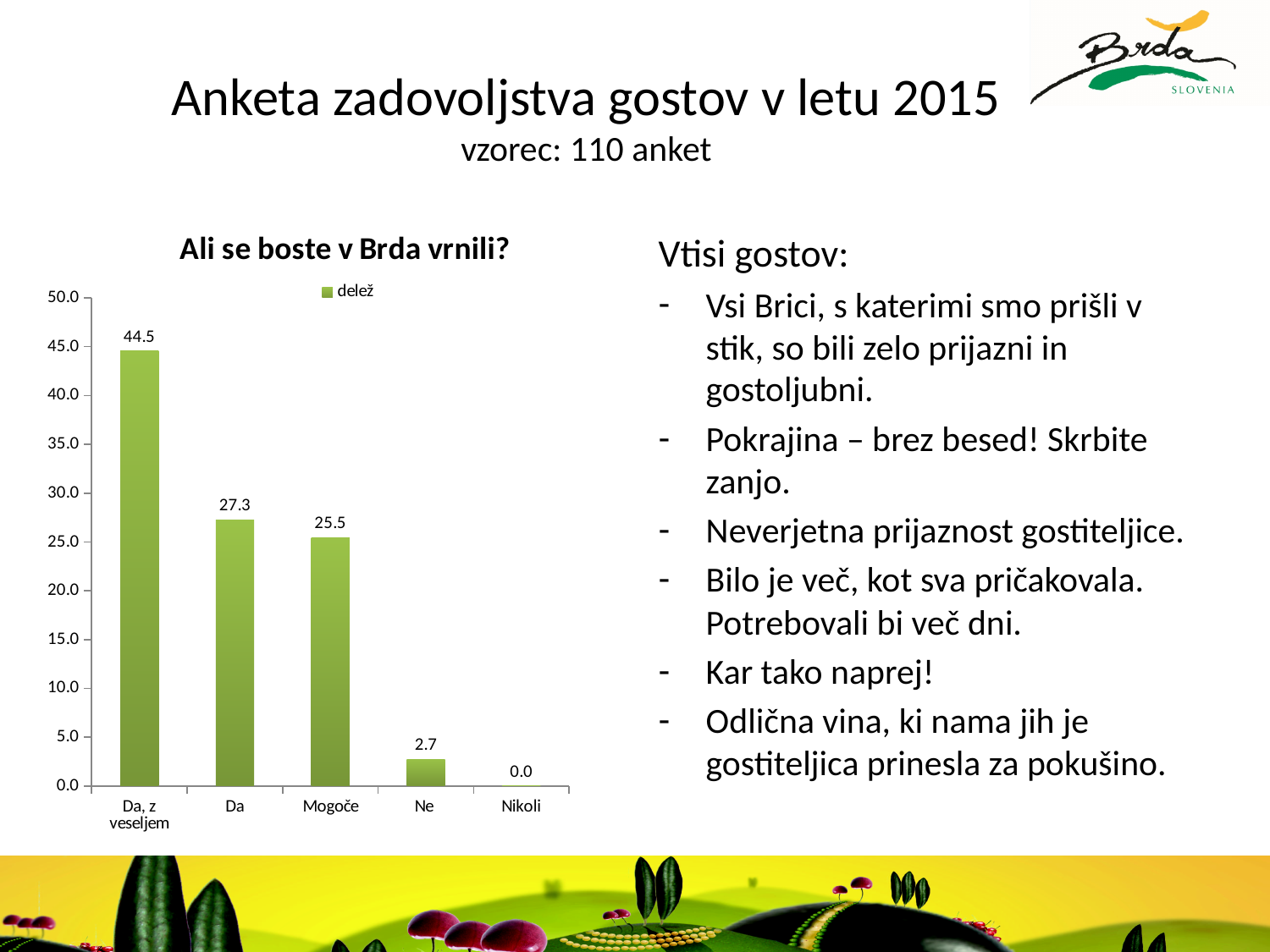
What is the value for "Nikoli"? 0.0 What is the value for "Mogoče"? 25.5 What is the title of the chart? Ali se boste v Brda vrnili? Which category has the highest value? Da, z veseljem What is the value for "Da, z veseljem"? 44.5 How many categories are shown on the x axis? 5 Which is larger, the value for "Da" or the value for "Mogoče"? Da How many series does the legend list? 1 Which category has the lowest value? Nikoli What is the difference between the values for "Da, z veseljem" and "Da"? 17.2 What is the value for "Ne"? 2.7 What kind of chart is shown on the slide? bar chart